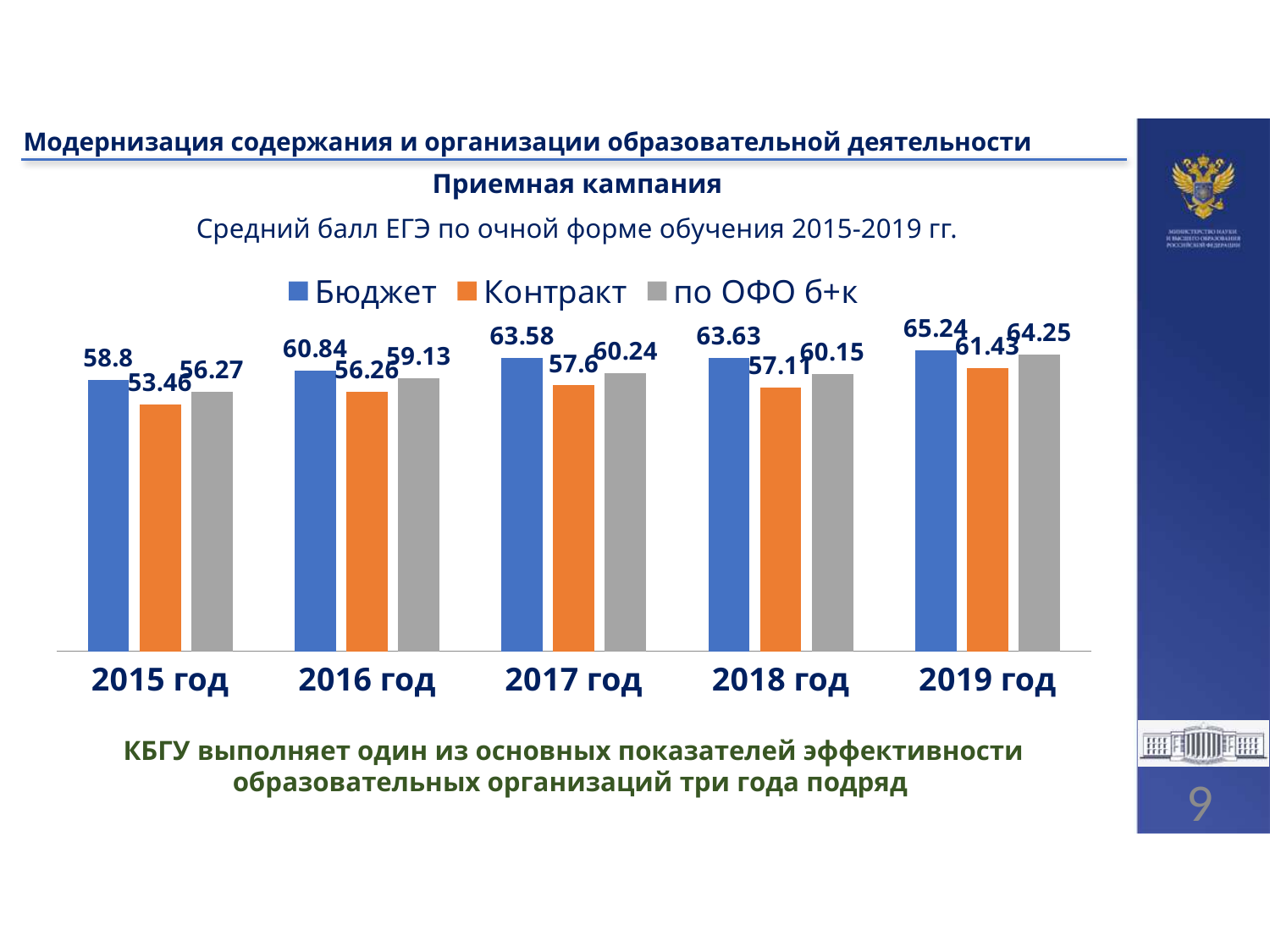
How many year categories are shown on the x axis? 5 How many series does the legend list? 3 Does the по ОФО б+к value generally rise or fall from 2015 год to 2019 год? rise What is the difference between the Бюджет and Контракт values in 2019 год? 3.81 In which year is the Контракт value lowest? 2015 год Which is larger in 2016 год: Бюджет or по ОФО б+к? Бюджет What is the value for Бюджет in 2015 год? 58.8 What is the value for по ОФО б+к in 2019 год? 64.25 Which colour represents the Контракт series in the legend? orange What is the value for Контракт in 2018 год? 57.11 What type of chart is shown on the slide? bar chart In which year is the Бюджет value highest? 2019 год